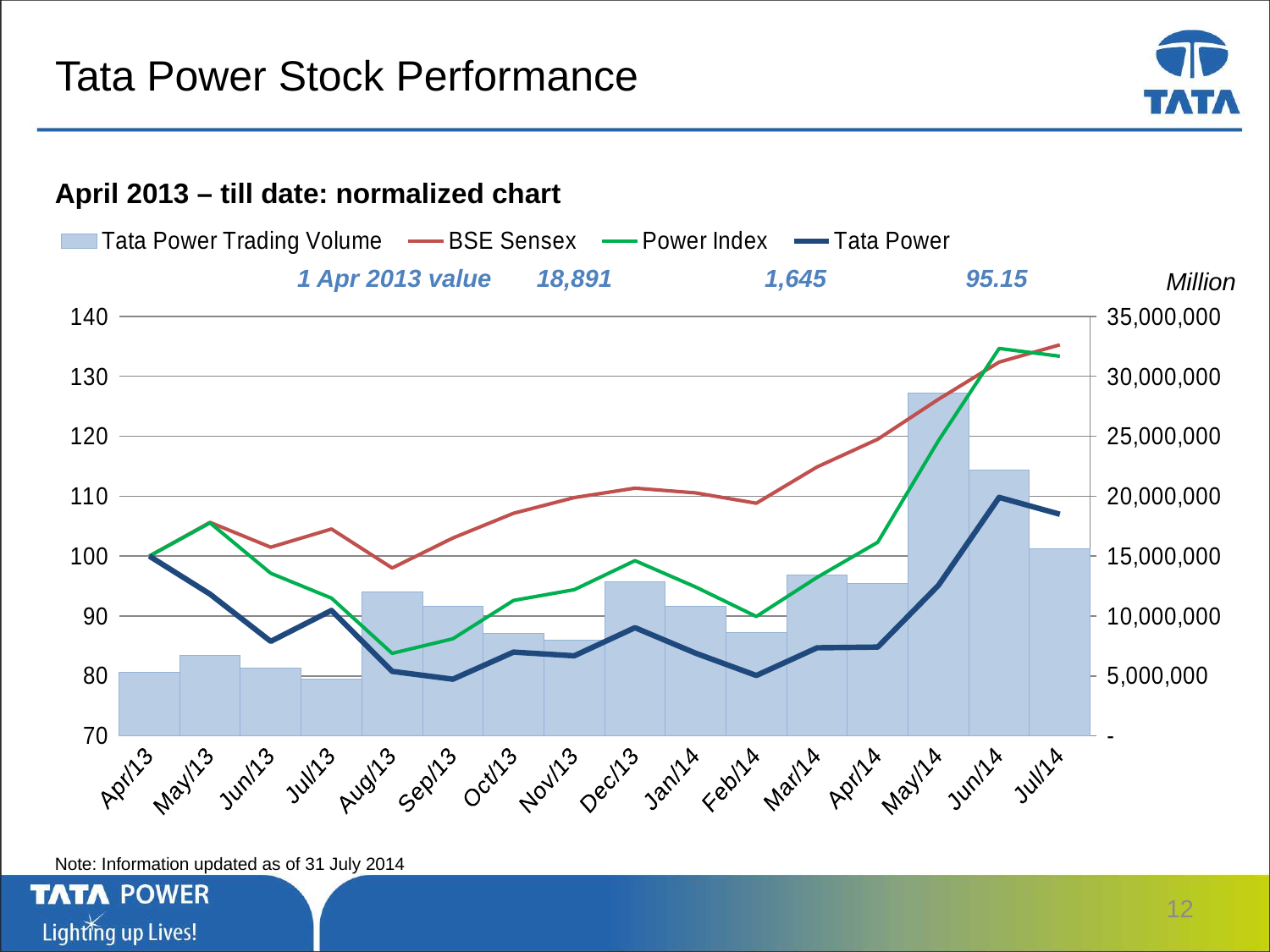
What is the 1 Apr 2013 value shown for the Power Index? 1,645 How many series does the chart legend list? 4 In Jul/14, which is higher on the chart: the BSE Sensex line or the Tata Power line? BSE Sensex Is the Tata Power line value for Feb/14 greater or less than 90? less Is the BSE Sensex line value for Jul/14 greater or less than 130? greater What is the 1 Apr 2013 value shown for BSE Sensex? 18,891 How many months are shown along the x axis of the chart? 16 What is the 1 Apr 2013 value shown for Tata Power? 95.15 What unit label is shown above the right-hand axis of the chart? Million Is the Tata Power Trading Volume for May/14 greater or less than 25,000,000? greater What kind of chart is shown on the slide? Combined bar and line chart In which month is the Tata Power Trading Volume bar the highest? May/14